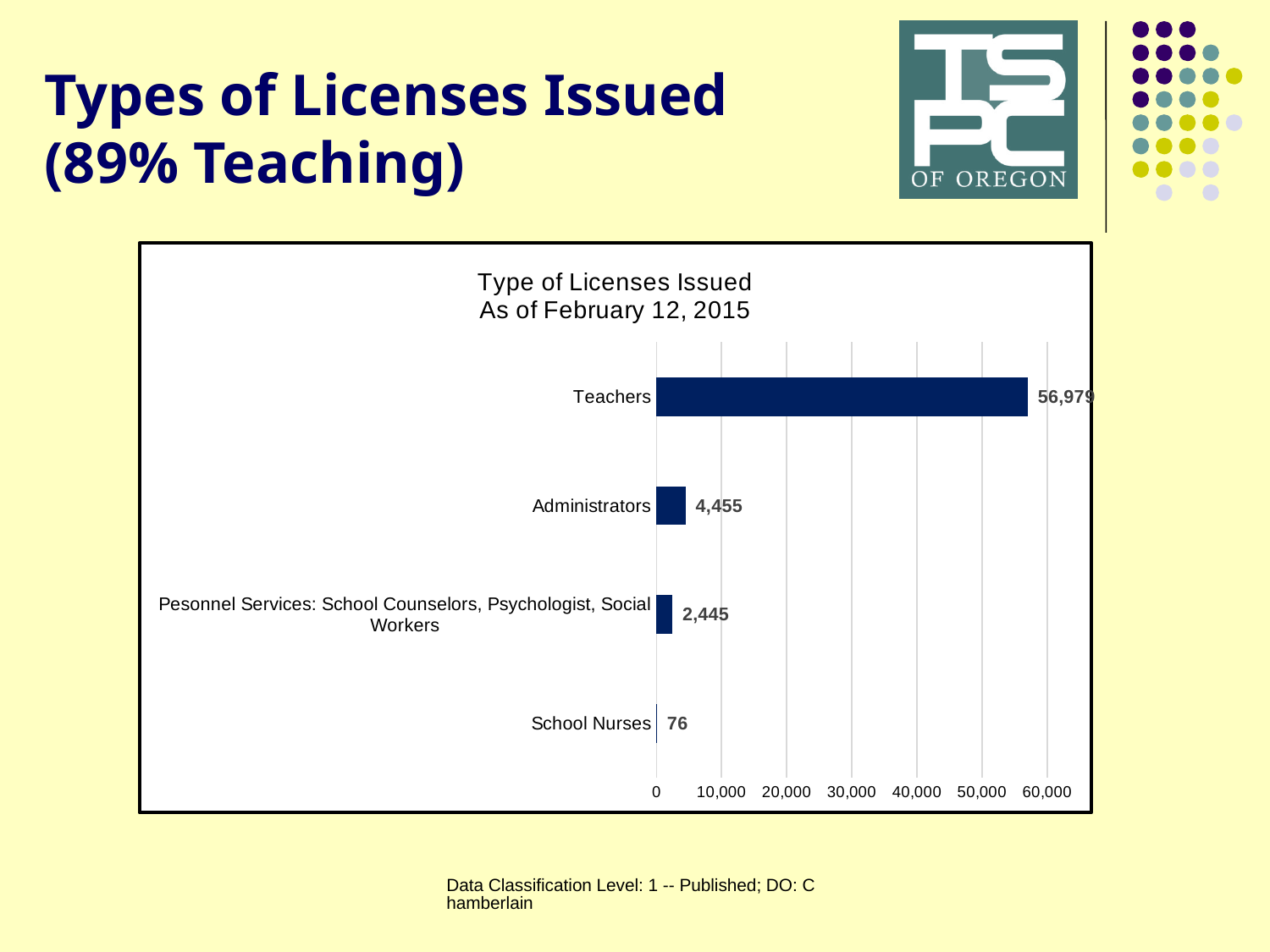
Is the value for Teachers greater or less than 50,000? greater What is the value for School Nurses? 76 What is the title of the chart? Type of Licenses Issued As of February 12, 2015 How many categories are shown in the chart? 4 What kind of chart is shown on the slide? bar chart What is the value for Administrators? 4,455 Which category has the lowest value? School Nurses Which category has the highest value? Teachers What is the difference between the values for Teachers and Administrators? 52,524 What is the value for Pesonnel Services: School Counselors, Psychologist, Social Workers? 2,445 Which is larger, the value for Administrators or the value for Pesonnel Services: School Counselors, Psychologist, Social Workers? Administrators What is the value for Teachers? 56,979